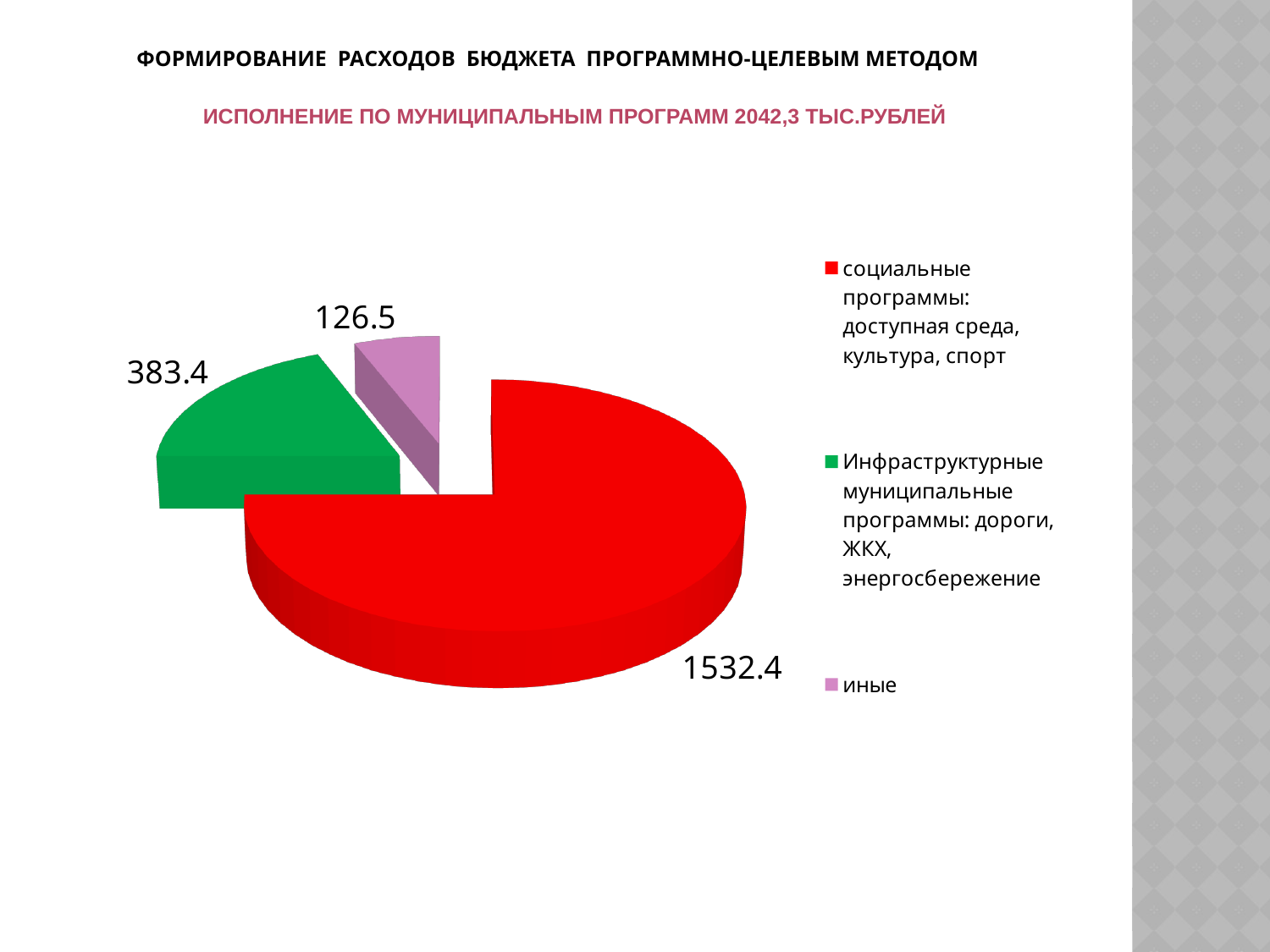
Which category has the largest slice of the pie? социальные программы: доступная среда, культура, спорт What is the total of all three slices of the pie chart? 2042.3 What is the value for Инфраструктурные муниципальные программы: дороги, ЖКХ, энергосбережение? 383.4 Which category has the smallest slice of the pie? иные What colour is the slice for иные? pink What is the value for иные? 126.5 What is the difference between the value for Инфраструктурные муниципальные программы and the value for иные? 256.9 What is the value for социальные программы: доступная среда, культура, спорт? 1532.4 How many slices does the pie chart have? 3 What is the difference between the value for социальные программы and the value for Инфраструктурные муниципальные программы? 1149.0 What kind of chart is shown on the slide? pie chart Which is larger: the value for Инфраструктурные муниципальные программы or the value for иные? Инфраструктурные муниципальные программы